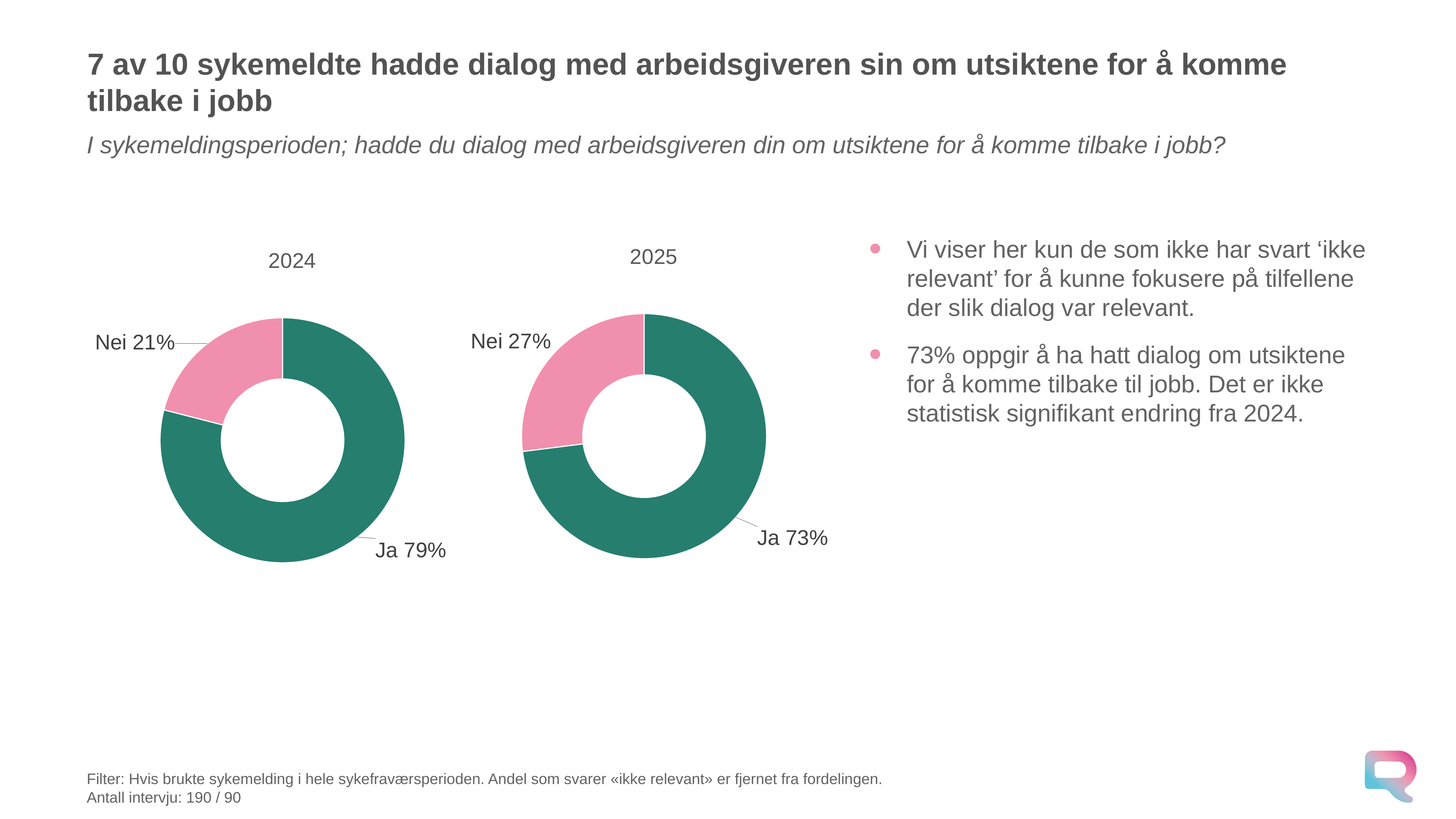
In the 2024 chart, what share of respondents answered "Nei"? 21% In the 2024 chart, which answer has the smallest share? Nei In the 2024 chart, what share of respondents answered "Ja"? 79% What kind of chart is used for the 2024 and 2025 data? Doughnut (pie) chart In the 2025 chart, what share of respondents answered "Nei"? 27% Is the "Ja" share larger in the 2024 chart or the 2025 chart? 2024 In the 2024 chart, what colour is the "Nei" slice? Pink In the 2025 chart, what share of respondents answered "Ja"? 73% In the 2024 chart, what is the difference between the "Ja" and "Nei" shares? 58 percentage points How many categories are shown in the 2025 chart? 2 By how many percentage points did the "Nei" share change from the 2024 chart to the 2025 chart? 6 percentage points In the 2025 chart, which answer has the largest share? Ja